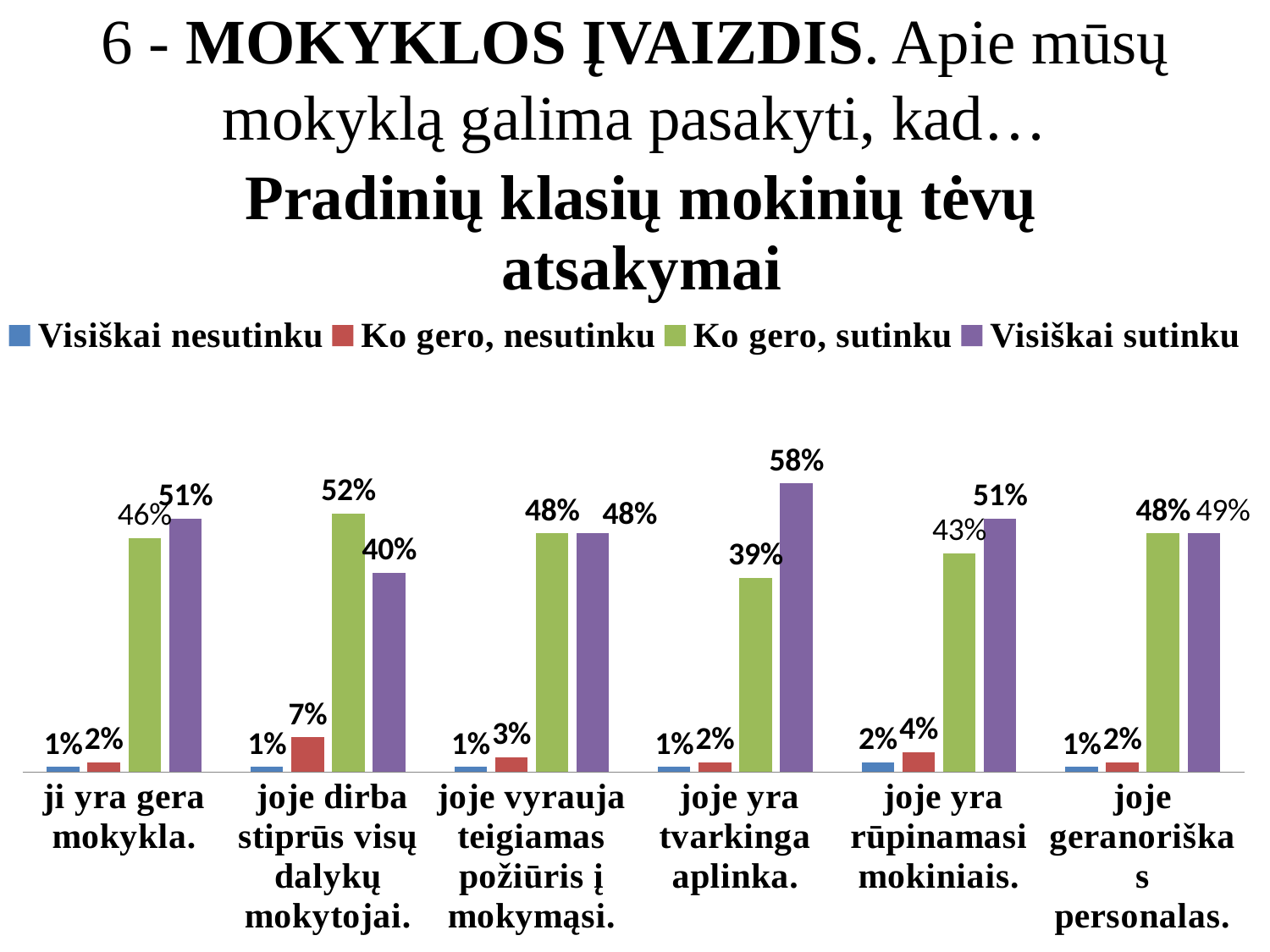
How many series does the legend list? 4 What kind of chart is shown on the slide? bar chart What is the value for "Ko gero, sutinku" for "joje dirba stiprūs visų dalykų mokytojai."? 52% Which category has the lowest value for "Ko gero, sutinku"? joje yra tvarkinga aplinka. What is the value for "Ko gero, nesutinku" for "joje dirba stiprūs visų dalykų mokytojai."? 7% How many categories are shown on the x axis? 6 What is the difference between the "Visiškai sutinku" and "Ko gero, sutinku" values for "joje yra tvarkinga aplinka."? 19% What is the value for "Visiškai sutinku" for "joje yra tvarkinga aplinka."? 58% Which category has the highest value for "Visiškai sutinku"? joje yra tvarkinga aplinka. Which legend entry is shown in green? Ko gero, sutinku What is the value for "Visiškai nesutinku" for "joje yra rūpinamasi mokiniais."? 2% Which is larger for "joje dirba stiprūs visų dalykų mokytojai.": "Ko gero, sutinku" or "Visiškai sutinku"? Ko gero, sutinku